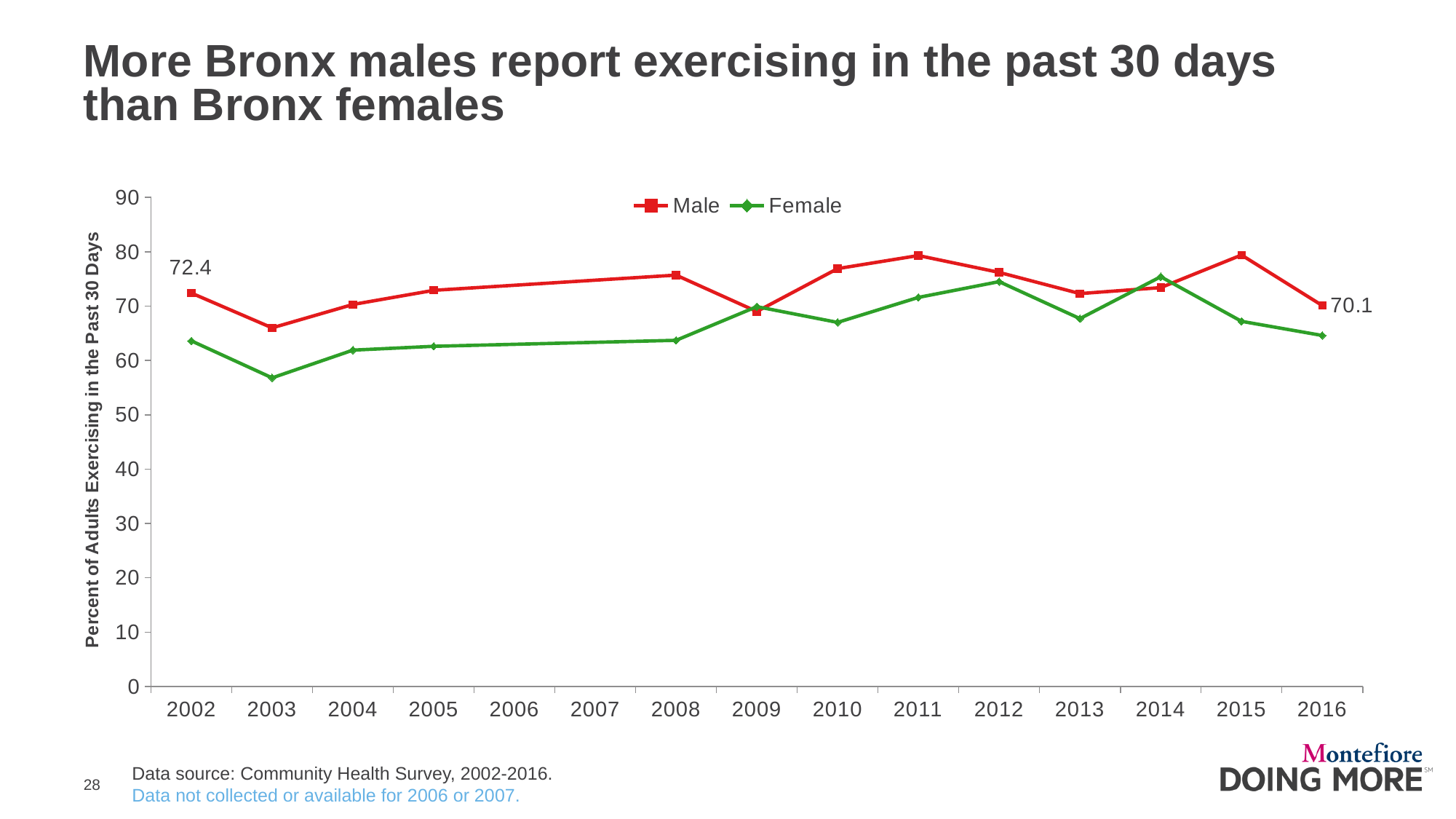
How many series does the legend list? 2 Does the Male value rise or fall from 2015 to 2016? Fall What is the value for Male in 2002? 72.4 In which year is the Male value lowest? 2003 Is the value for Female in 2003 greater or less than 60? less What is the difference between the Male value in 2002 and the Male value in 2016? 2.3 What is the value for Male in 2016? 70.1 In which year is the Female value lowest? 2003 Is the value for Male in 2011 greater or less than 70? greater In 2002, which series has the higher value, Male or Female? Male What is the title of the vertical axis? Percent of Adults Exercising in the Past 30 Days What kind of chart is shown on the slide? Line chart